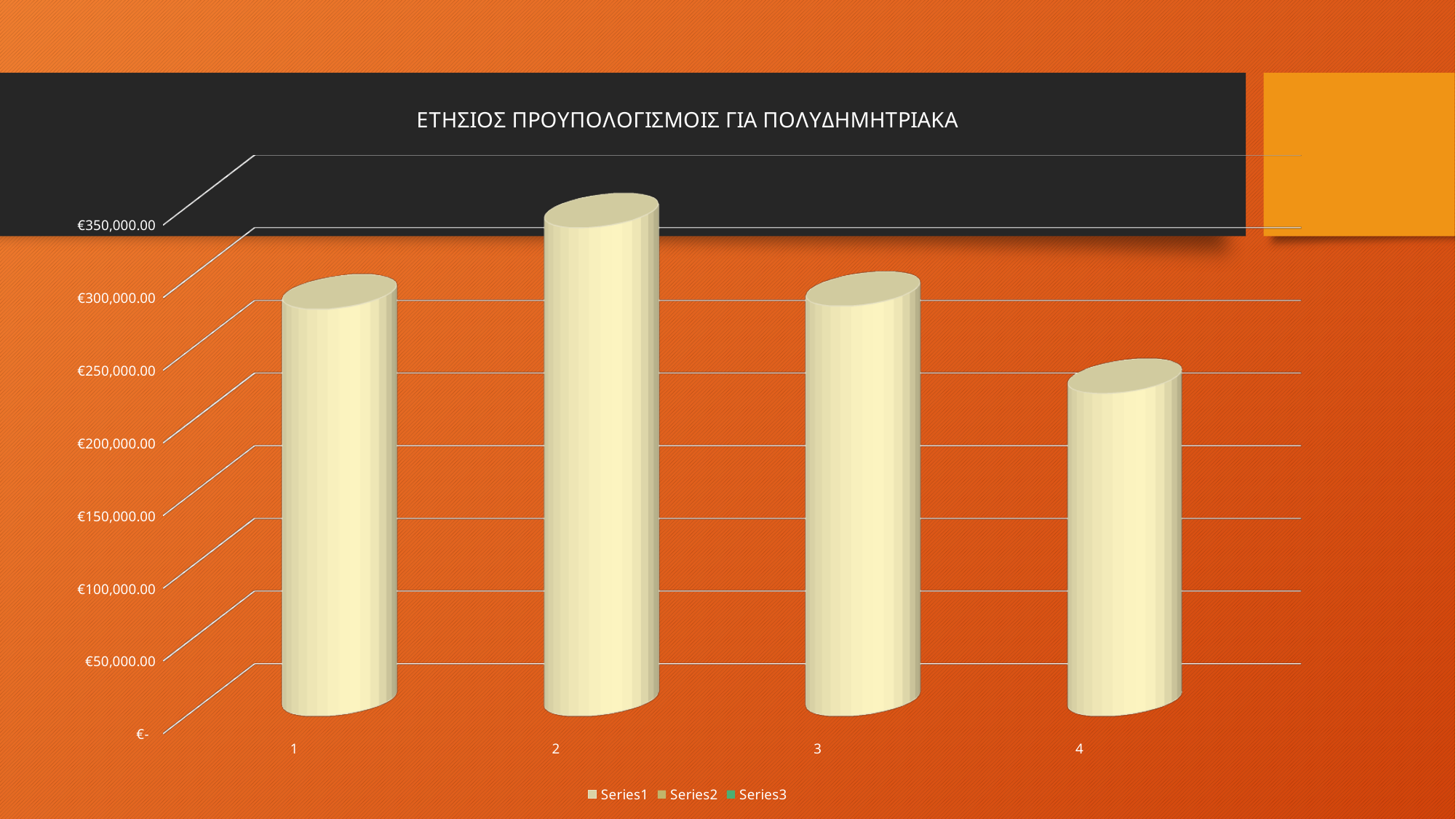
Is the value for category 1 greater or less than €250,000.00? greater From category 2 to category 4, do the values rise or fall? fall What kind of chart is shown on the slide? bar chart How many categories are shown on the x axis? 4 Which is larger, the value for category 2 or the value for category 4? category 2 Is the value for category 4 greater or less than €200,000.00? greater What is the title of the chart? ΕΤΗΣΙΟΣ ΠΡΟΥΠΟΛΟΓΙΣΜΟΙΣ ΓΙΑ ΠΟΛΥΔΗΜΗΤΡΙΑΚΑ Which category has the highest value? 2 Is the value for category 2 greater or less than €300,000.00? greater Which category has the lowest value? 4 How many series does the legend list? 3